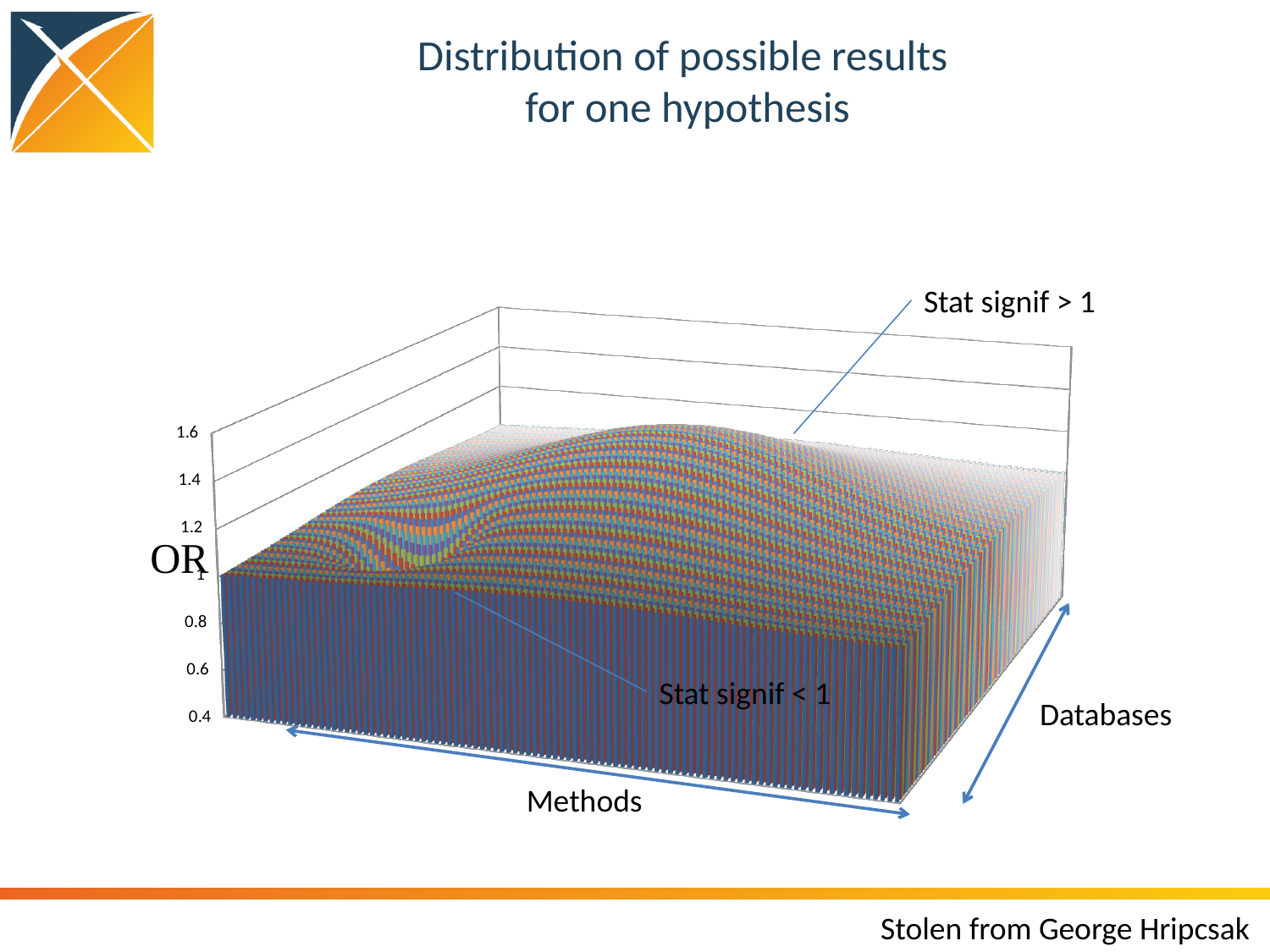
What is the lowest tick value shown on the vertical axis? 0.4 What kind of chart is shown on the slide? 3D surface chart What is the title of the chart on the slide? Distribution of possible results for one hypothesis Is the peak of the surface greater or less than 1.6 on the OR axis? less What is the highest tick value shown on the vertical axis? 1.6 What label is shown on the vertical axis of the chart? OR Is the peak of the surface greater or less than 1.2 on the OR axis? greater How many tick labels are shown on the vertical axis? 7